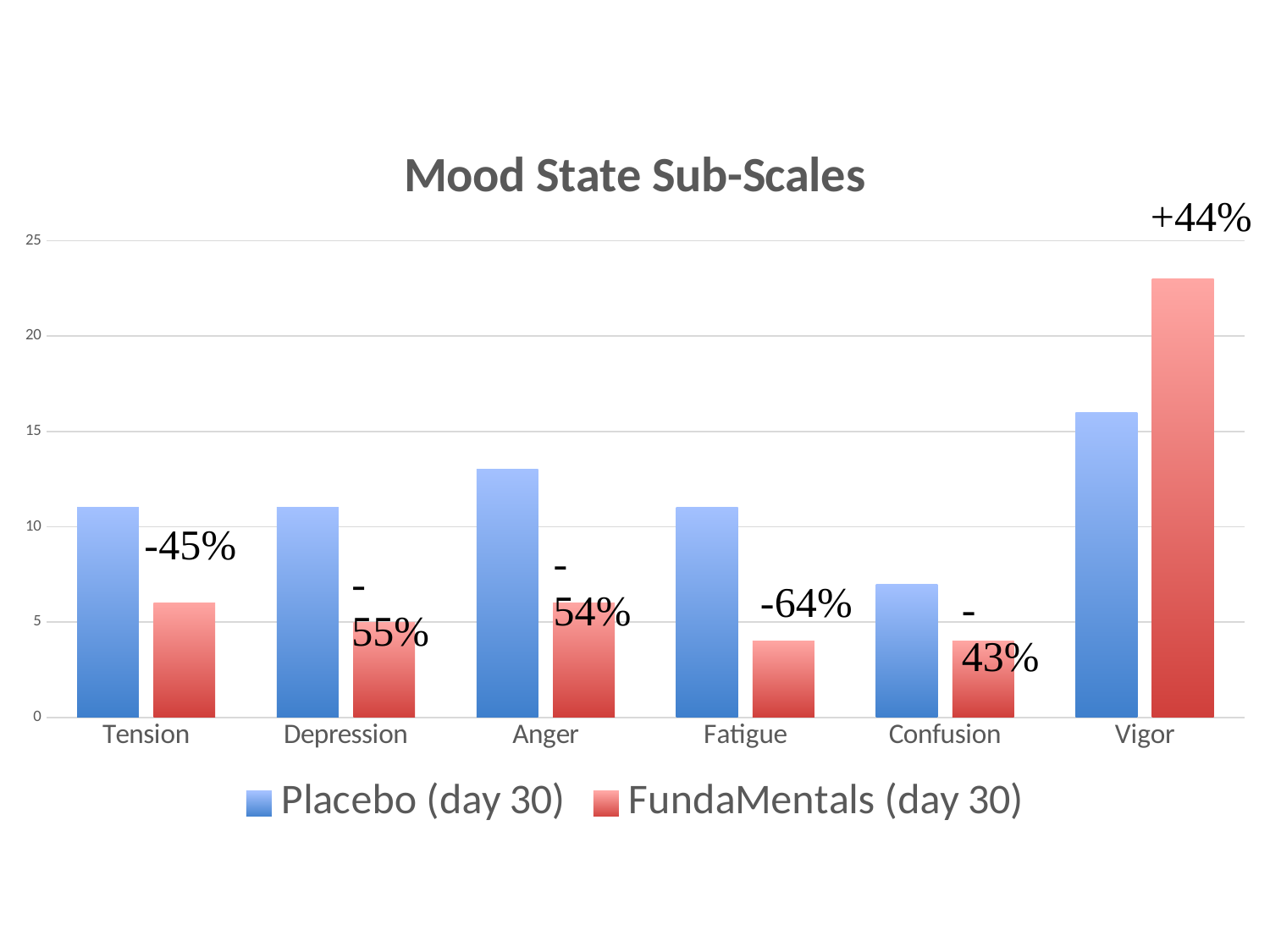
What percentage change is printed above the FundaMentals bar for Vigor? +44% How many series does the legend list? 2 Is the FundaMentals (day 30) value for Vigor greater or less than 20? greater What kind of chart is shown on the slide? bar chart What percentage change is printed above the FundaMentals bar for Fatigue? -64% Which category has the highest Placebo (day 30) bar? Vigor What percentage change is printed next to the FundaMentals bar for Tension? -45% For Vigor, which is larger: the Placebo (day 30) bar or the FundaMentals (day 30) bar? FundaMentals (day 30) Which series is shown in red? FundaMentals (day 30) How many mood sub-scale categories are shown on the x axis? 6 Which category has the lowest Placebo (day 30) bar? Confusion What is the title of the chart? Mood State Sub-Scales